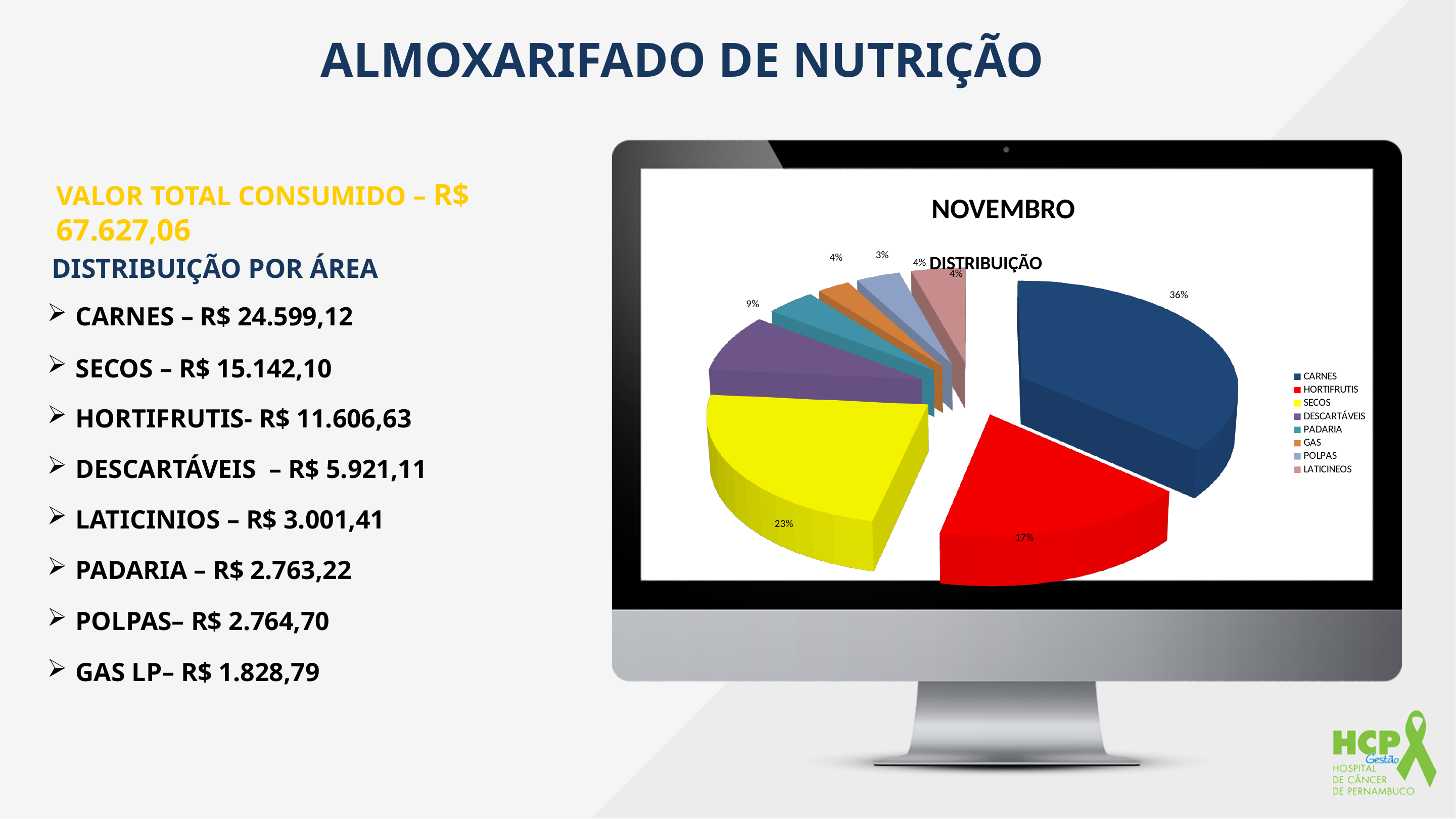
What percentage of the pie chart does CARNES represent? 36% What percentage of the pie chart does HORTIFRUTIS represent? 17% Which category has the smallest slice of the pie chart? GAS By how many percentage points does the CARNES slice exceed the SECOS slice? 13 percentage points What type of chart is shown on the slide? Pie chart What percentage of the pie chart does DESCARTÁVEIS represent? 9% How many categories are shown in the pie chart legend? 8 What percentage of the pie chart does SECOS represent? 23% What is the title shown above the pie chart? NOVEMBRO Which category has the largest slice of the pie chart? CARNES What percentage of the pie chart does GAS represent? 3% Which slice is larger in the pie chart, SECOS or HORTIFRUTIS? SECOS